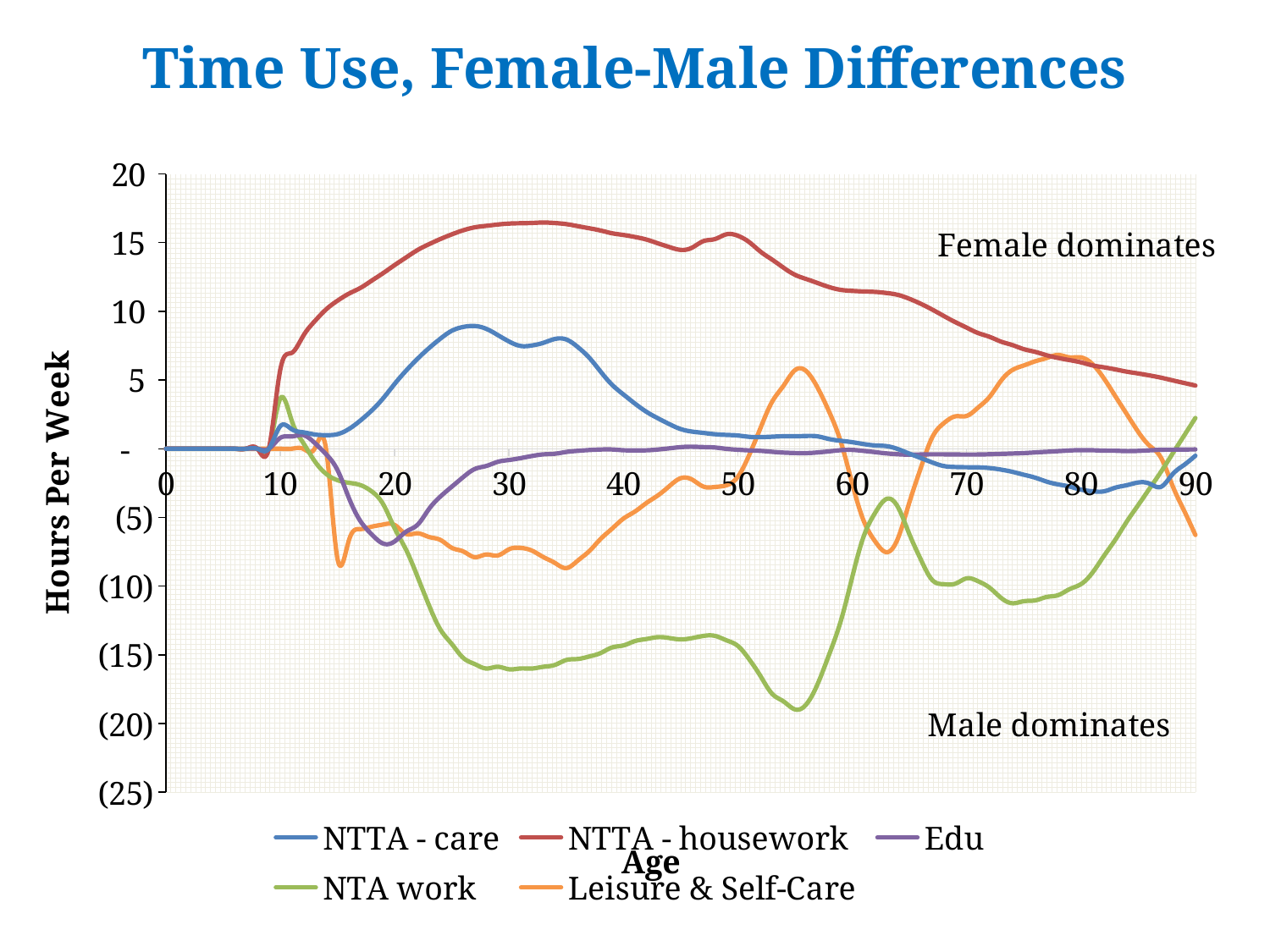
Which series reaches the highest value on the chart? NTTA - housework Is the value for Leisure & Self-Care at age 20 greater or less than (5)? less At age 30, which series has the higher value, NTTA - housework or NTTA - care? NTTA - housework How many series does the legend list? 5 Does the NTTA - housework line rise or fall between age 35 and age 90? fall Is the value for NTTA - housework at age 70 greater or less than 5? greater Which series reaches the lowest value on the chart? NTA work Is the value for NTTA - housework at age 30 greater or less than 15? greater What kind of chart is shown on the slide? line chart What is the title of the chart? Time Use, Female-Male Differences What is the label on the vertical axis? Hours Per Week